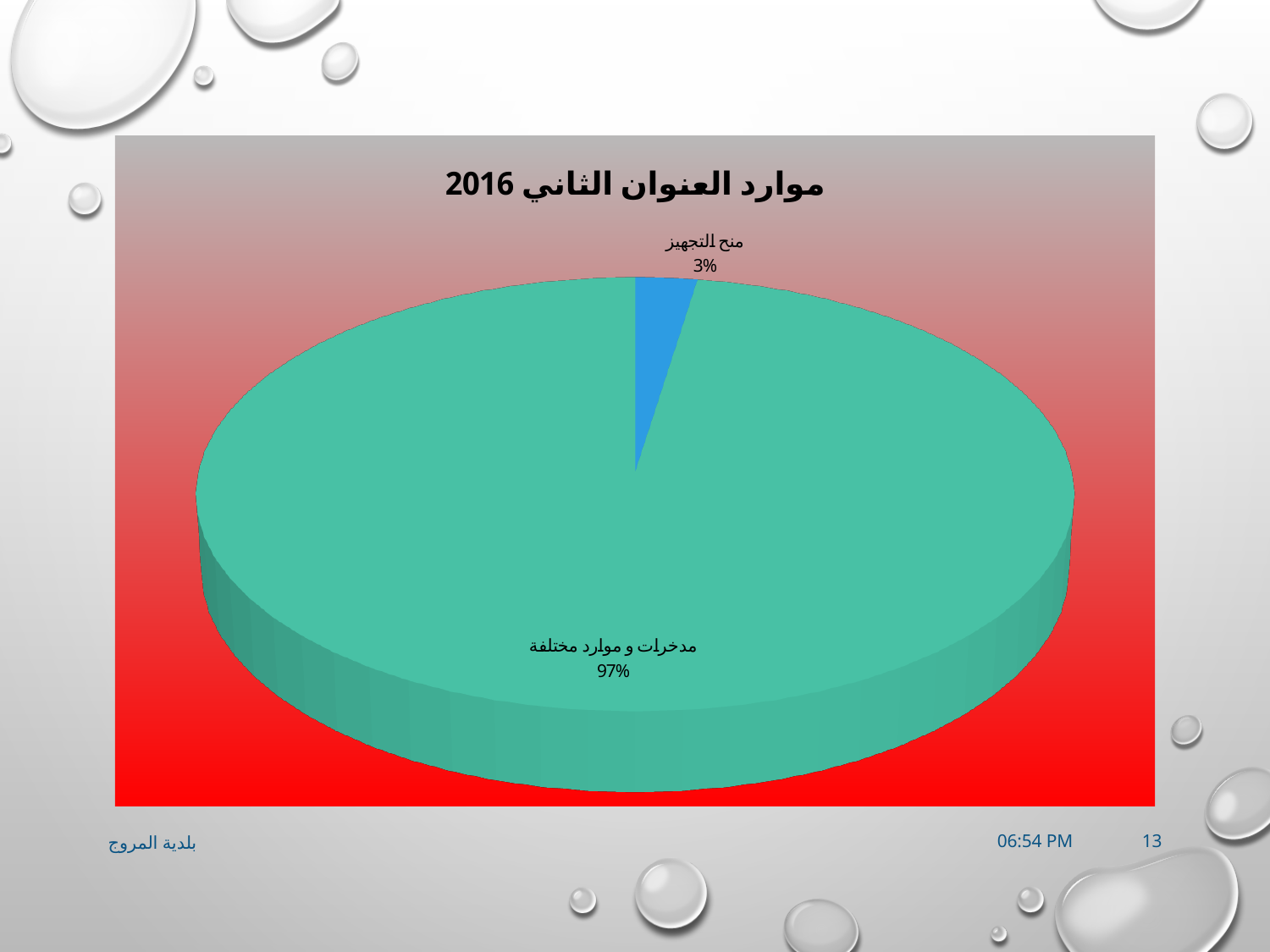
What share of the pie does "مدخرات و موارد مختلفة" represent? 97% Which is larger, the share for "منح التجهيز" or the share for "مدخرات و موارد مختلفة"? مدخرات و موارد مختلفة What kind of chart is shown on the slide? pie chart Is the share for "مدخرات و موارد مختلفة" greater or less than 50%? greater Which slice of the pie is the largest? مدخرات و موارد مختلفة What is the difference in percentage points between "مدخرات و موارد مختلفة" and "منح التجهيز"? 94 How many slices does the pie chart have? 2 Which slice of the pie is the smallest? منح التجهيز What share of the pie does "منح التجهيز" represent? 3% What colour is the slice for "منح التجهيز"? blue What is the title of the chart? موارد العنوان الثاني 2016